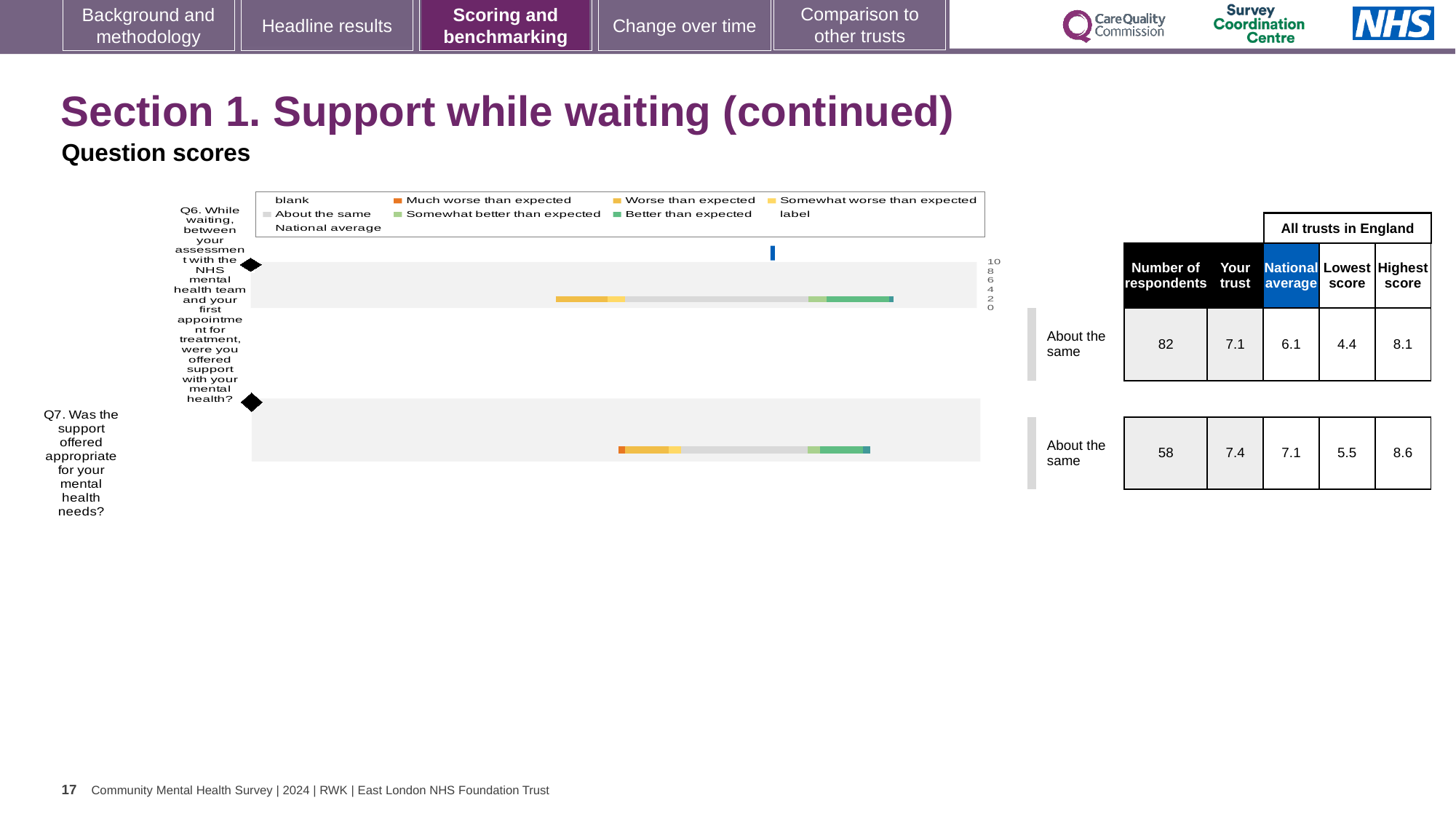
Which question has the higher 'Your trust' score, Q6 or Q7? Q7 What is the 'Your trust' score for Q7? 7.4 How many questions (categories) are plotted in the chart? 2 What is the highest score among all trusts in England for Q7? 8.6 What is the maximum value shown on the chart's score axis? 10 What is the 'Your trust' score for Q6? 7.1 What benchmark category is shown for Q7? About the same What is the national average score for Q6? 6.1 What is the difference between the highest score and the lowest score for Q6? 3.7 How many respondents answered Q6? 82 What is the difference between the 'Your trust' score and the national average for Q7? 0.3 What kind of chart is used to show the question scores on this slide? bar chart